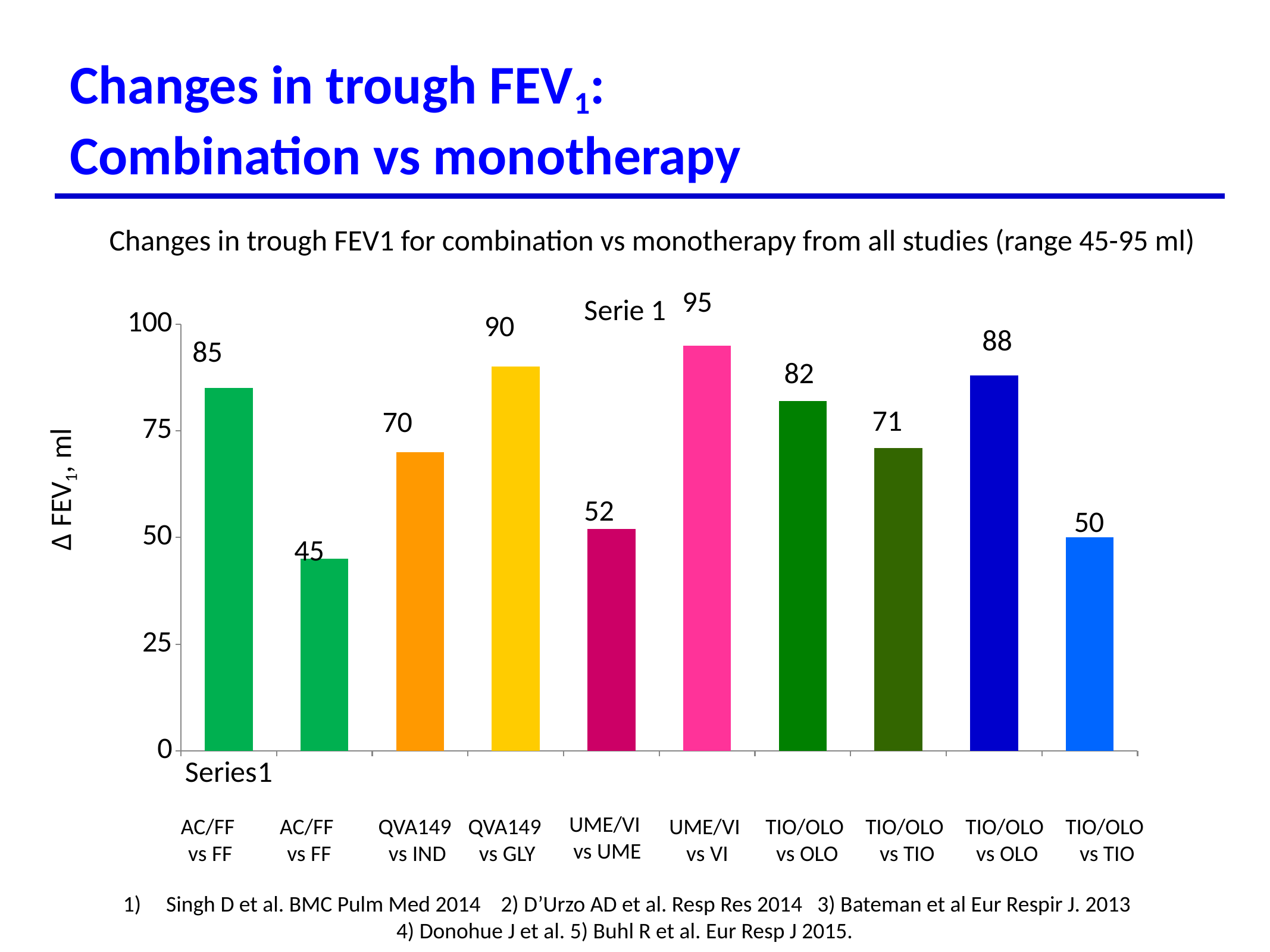
Which category has the highest value? UME/VI vs VI How many bars are plotted in the chart? 10 What is the difference between the values for UME/VI vs VI and UME/VI vs UME? 43 What is the value for UME/VI vs UME? 52 What is the value for QVA149 vs GLY? 90 What is the value of the leftmost bar (the first AC/FF vs FF bar)? 85 What is the value for QVA149 vs IND? 70 Which is larger, the value for QVA149 vs GLY or the value for QVA149 vs IND? QVA149 vs GLY What is the label of the y axis? Δ FEV1, ml What is the lowest value shown in the chart? 45 What type of chart is shown on the slide? bar chart What is the difference between the first TIO/OLO vs OLO bar (82) and the first TIO/OLO vs TIO bar (71)? 11